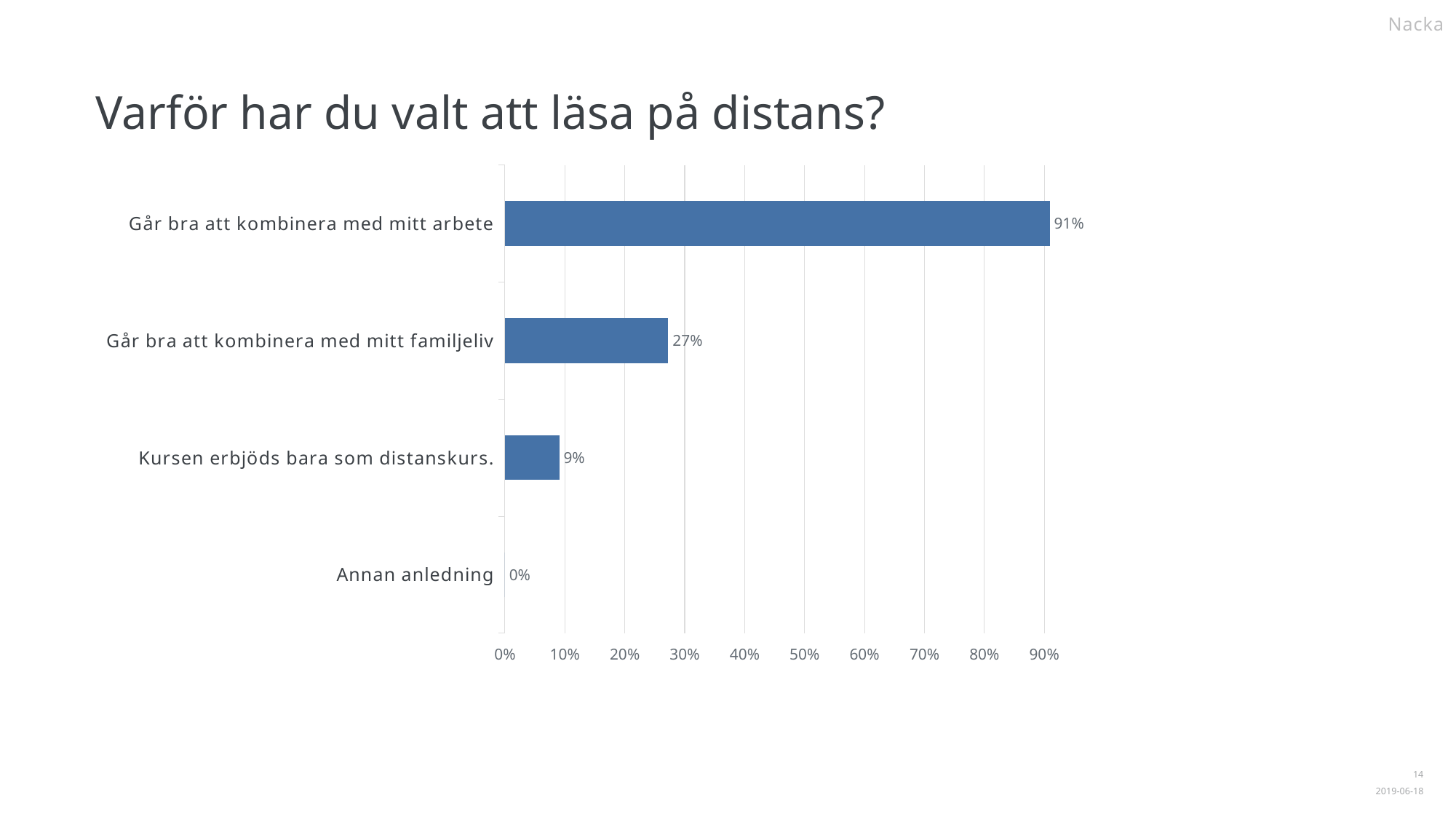
Which category has the lowest value? Annan anledning Which is larger: the value for "Går bra att kombinera med mitt familjeliv" or "Kursen erbjöds bara som distanskurs."? Går bra att kombinera med mitt familjeliv What kind of chart is shown on the slide? bar chart What is the value for "Går bra att kombinera med mitt arbete"? 91% What is the difference between the values for "Går bra att kombinera med mitt arbete" and "Går bra att kombinera med mitt familjeliv"? 64% Which category has the highest value? Går bra att kombinera med mitt arbete Is the value for "Går bra att kombinera med mitt familjeliv" greater or less than 30%? less What is the value for "Annan anledning"? 0% How many categories are shown in the chart? 4 What is the value for "Kursen erbjöds bara som distanskurs."? 9% What is the value for "Går bra att kombinera med mitt familjeliv"? 27% What is the title of the slide containing the chart? Varför har du valt att läsa på distans?